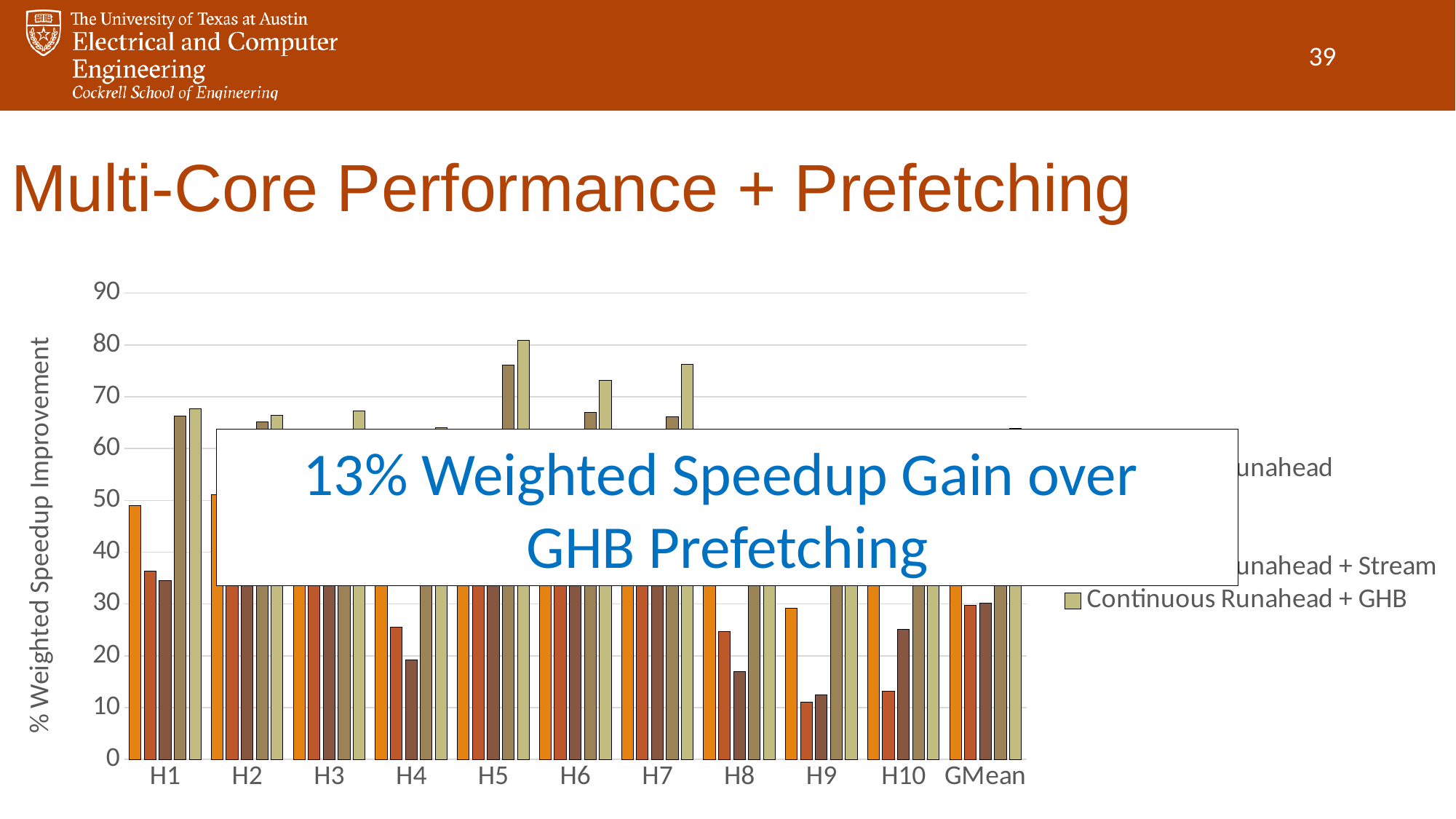
Is the Continuous Runahead + GHB value for H5 greater or less than 70? greater What kind of chart is shown on the slide? bar chart Is the value of the brown (third) bar for H9 greater or less than 20? less What does the callout box over the chart say? 13% Weighted Speedup Gain over GHB Prefetching Is the Continuous Runahead + GHB value for H1 greater or less than 60? greater How many categories are shown along the x axis of the chart? 11 Which category has the highest Continuous Runahead + GHB bar? H5 What is the label of the y axis of the chart? % Weighted Speedup Improvement